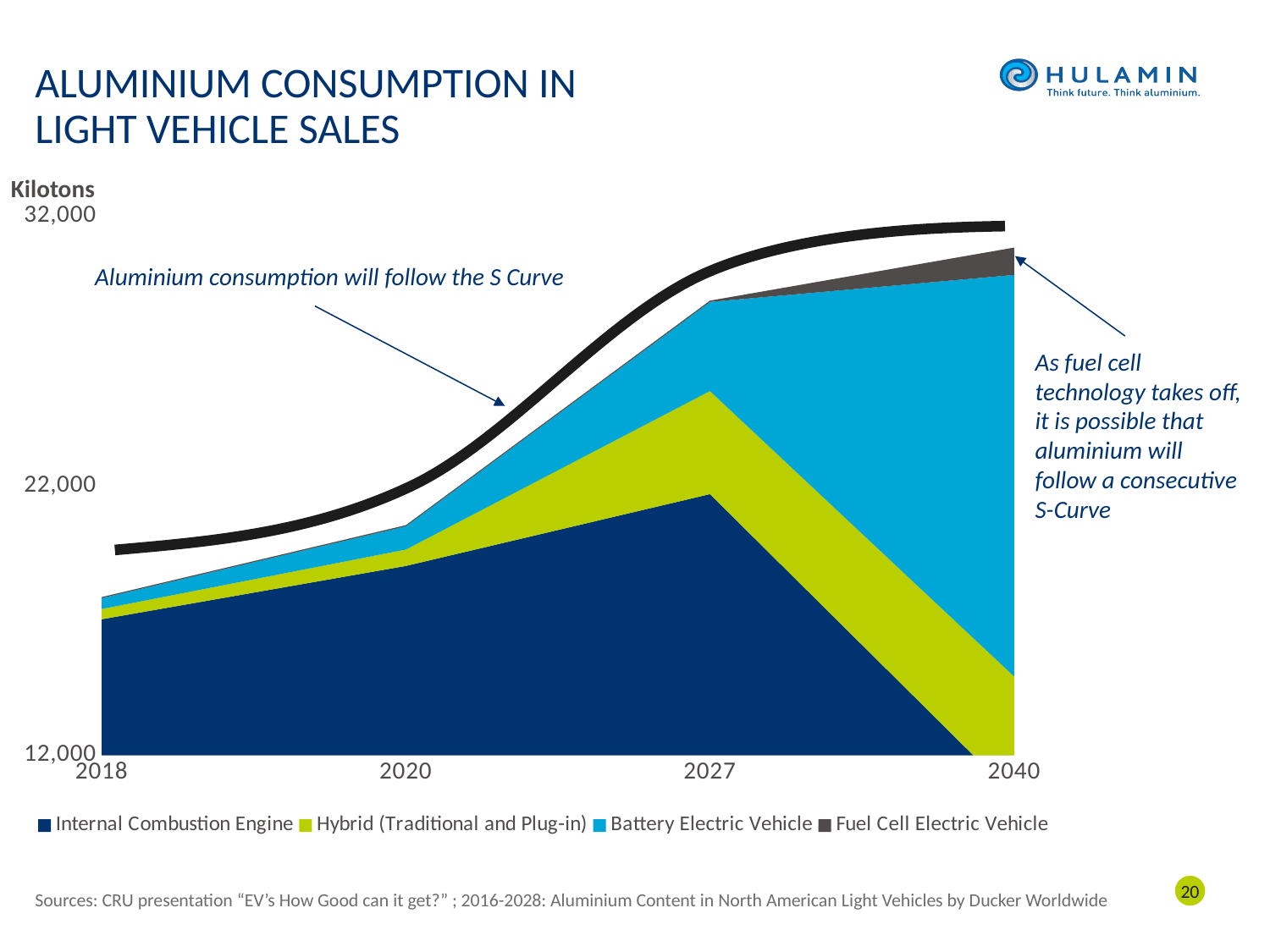
Is the total aluminium consumption in 2027 greater or less than 22,000 kilotons? greater Which series is the largest contributor to aluminium consumption in 2018? Internal Combustion Engine How many series does the legend list? 4 What is the title of the chart? Aluminium Consumption in Light Vehicle Sales Is the Internal Combustion Engine contribution larger in 2018 or in 2040? 2018 How many years are labelled on the x axis? 4 Does total aluminium consumption rise or fall from 2018 to 2040? Rise Is the total aluminium consumption in 2018 greater or less than 22,000 kilotons? less What unit is shown for the y axis? Kilotons Which series is the largest contributor to aluminium consumption in 2040? Battery Electric Vehicle Which series is the smallest contributor to aluminium consumption in 2040? Fuel Cell Electric Vehicle What kind of chart is shown on the slide? Stacked area chart